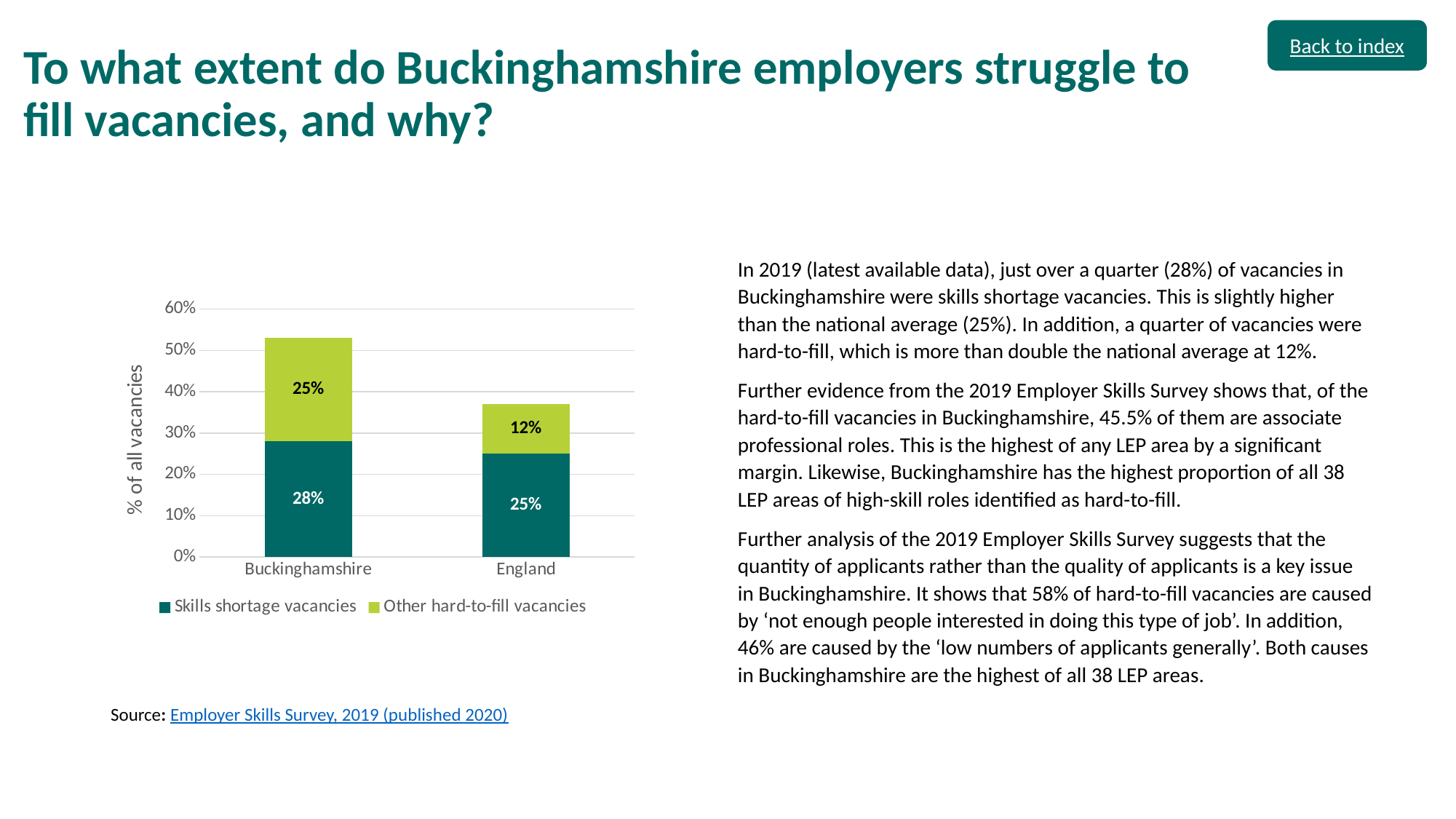
What is the value for Skills shortage vacancies in England? 25% What is the value for Other hard-to-fill vacancies in England? 12% What is the difference between the Other hard-to-fill vacancies values for Buckinghamshire and England? 13% Which area has the higher value for Other hard-to-fill vacancies? Buckinghamshire Is the Skills shortage vacancies value for England larger or smaller than the Skills shortage vacancies value for Buckinghamshire? smaller What is the value for Other hard-to-fill vacancies in Buckinghamshire? 25% What is the total of the stacked bar for England? 37% What kind of chart is shown on the slide? Stacked bar chart How many series does the legend list? 2 How many categories are shown on the x axis? 2 What is the value for Skills shortage vacancies in Buckinghamshire? 28% What is the total of the stacked bar for Buckinghamshire? 53%